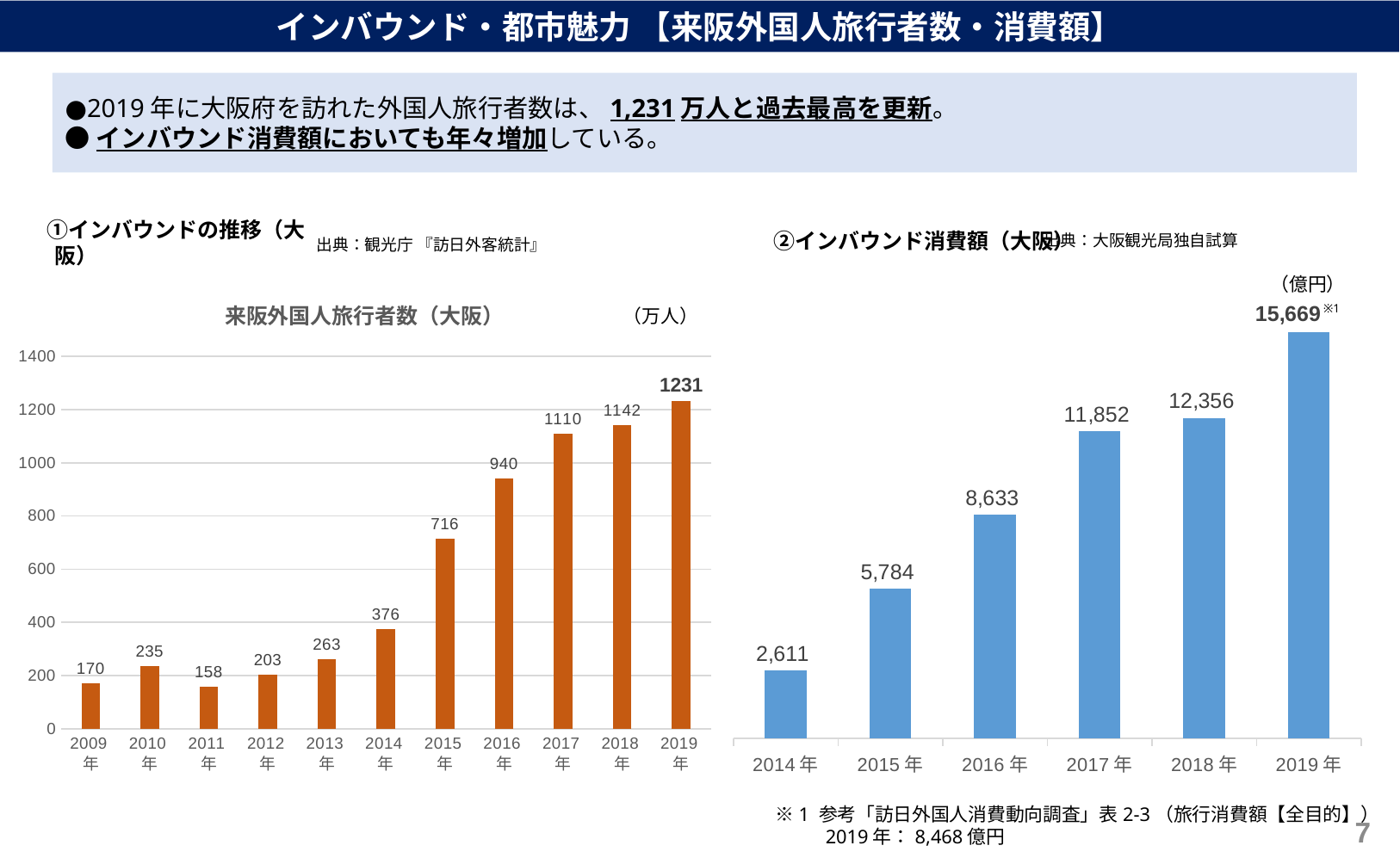
In the right chart (②インバウンド消費額（大阪）), what is the value for 2017年? 11,852 What type of chart is the right chart (②インバウンド消費額（大阪）)? bar chart In the left chart (来阪外国人旅行者数（大阪）), which year has the highest value? 2019年 In the right chart (②インバウンド消費額（大阪）), what is the value for 2014年? 2,611 In the right chart (②インバウンド消費額（大阪）), which is larger, the value for 2016年 or 2015年? 2016年 In the left chart (来阪外国人旅行者数（大阪）), which year has the lowest value? 2011年 In the left chart (来阪外国人旅行者数（大阪）), what is the value for 2015年? 716 In the right chart (②インバウンド消費額（大阪）), do the values rise or fall from 2014年 to 2019年? rise In the right chart (②インバウンド消費額（大阪）), what is the difference between the values for 2019年 and 2018年? 3,313 In the left chart (来阪外国人旅行者数（大阪）), how many years are plotted? 11 In the left chart (来阪外国人旅行者数（大阪）), is the value for 2016年 greater or less than 1000? less In the left chart (来阪外国人旅行者数（大阪）), what is the difference between the values for 2019年 and 2018年? 89